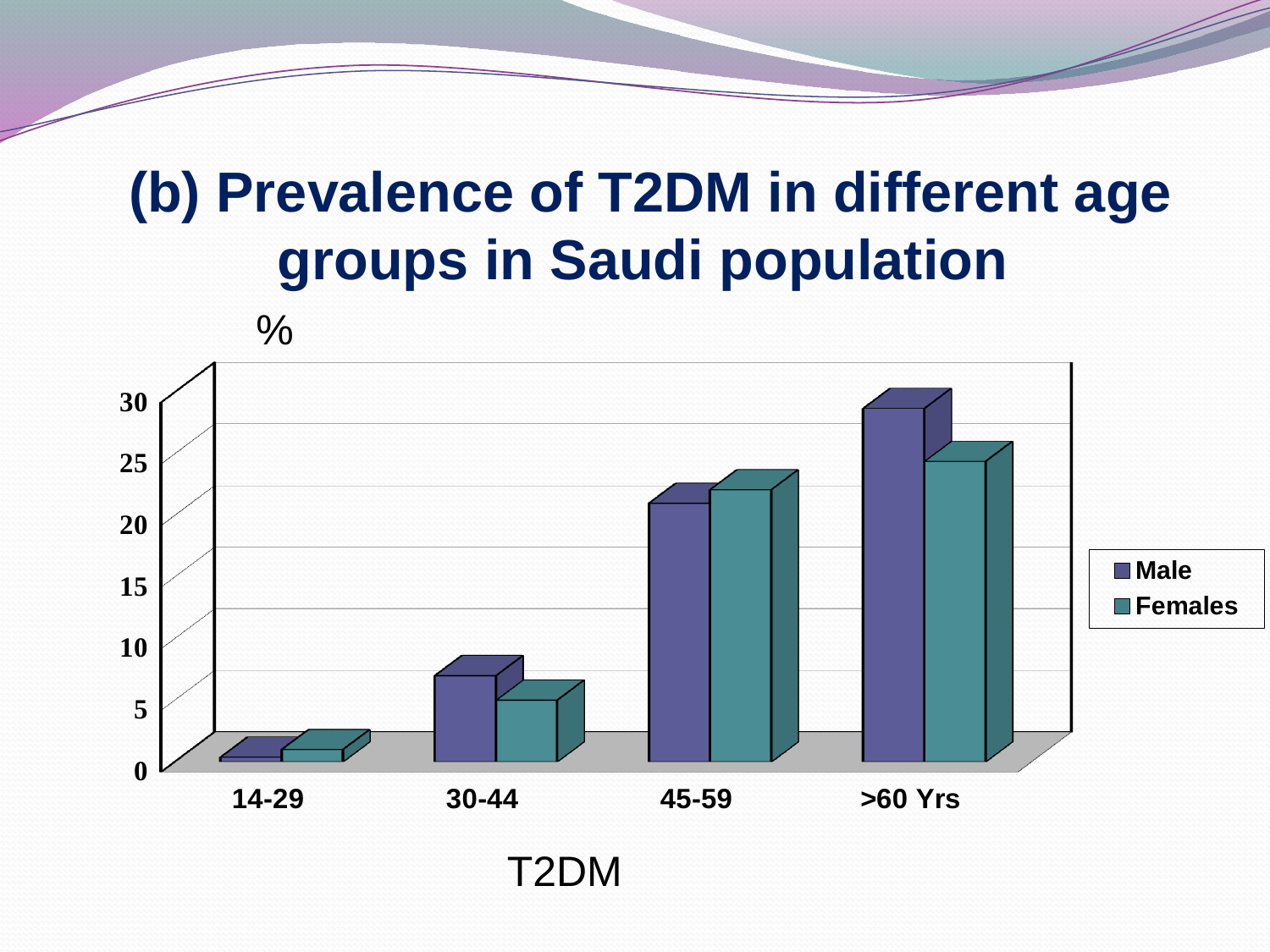
How many series does the legend list? 2 For the >60 Yrs group, which is larger, the Male or the Females value? Male Is the Male value for >60 Yrs greater or less than 25? greater Is the Male value for 45-59 greater or less than 15? greater Do the Male values rise or fall as age group increases along the x axis? rise Is the Females value for >60 Yrs greater or less than 20? greater Which age group has the lowest Females prevalence? 14-29 What kind of chart is shown on the slide? bar chart What unit is shown on the vertical axis label? % Which age group has the highest Male prevalence? >60 Yrs How many age groups are shown on the x axis? 4